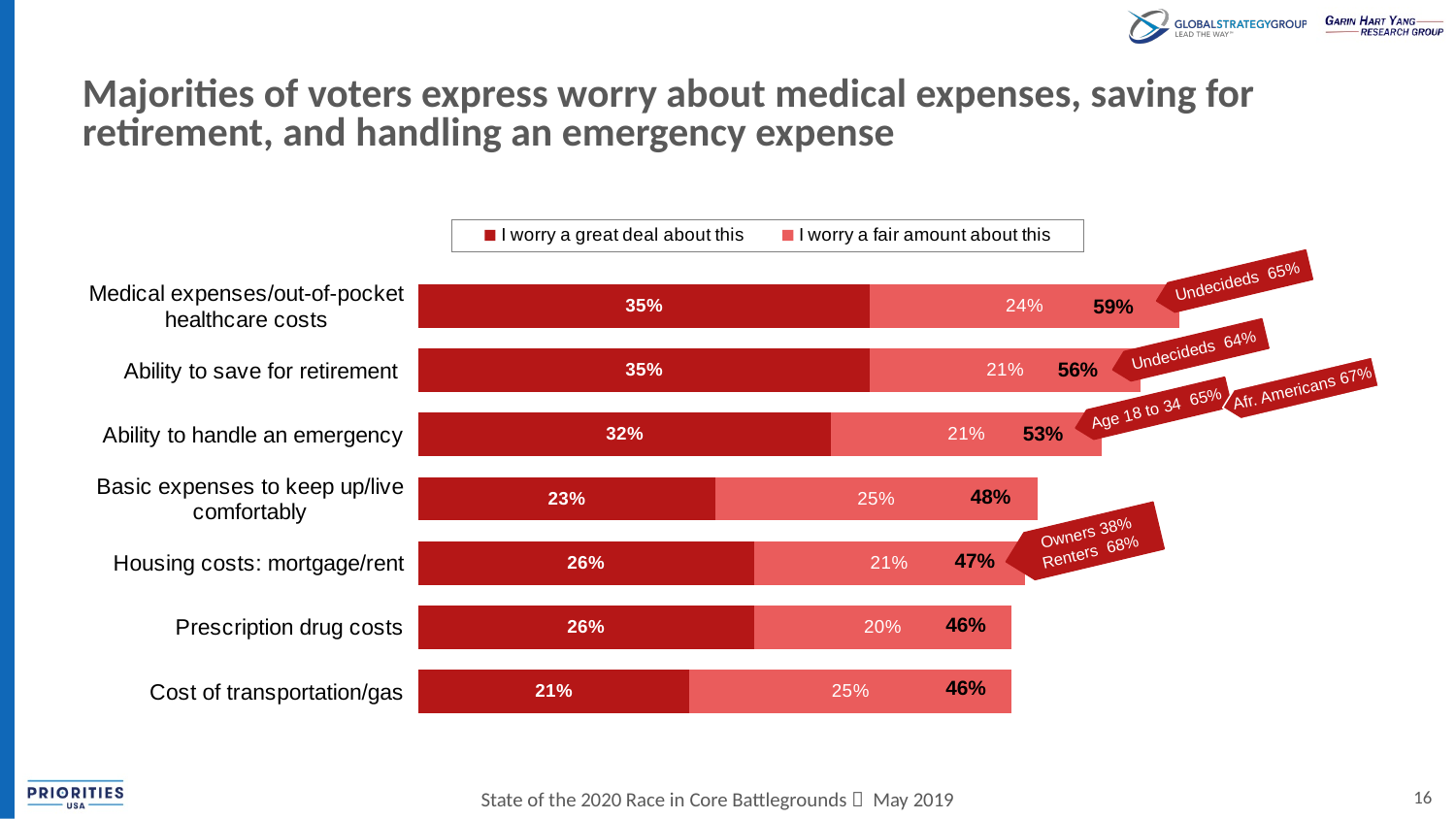
How many series does the legend list? 2 What percentage of voters say they worry a fair amount about the cost of transportation/gas? 25% Which category has the highest combined total of voters who worry a great deal or a fair amount? Medical expenses/out-of-pocket healthcare costs What is the combined total shown for 'Housing costs: mortgage/rent'? 47% What kind of chart is shown on the slide? Stacked bar chart What percentage of voters say they worry a great deal about medical expenses/out-of-pocket healthcare costs? 35% What is the combined total shown for 'Ability to handle an emergency'? 53% What is the difference between the 'I worry a great deal about this' values for 'Ability to save for retirement' and 'Housing costs: mortgage/rent'? 9 percentage points Which category has the lowest 'I worry a great deal about this' value? Cost of transportation/gas How many categories are plotted in the chart? 7 Which is larger: the 'I worry a fair amount about this' value for 'Basic expenses to keep up/live comfortably' or for 'Prescription drug costs'? Basic expenses to keep up/live comfortably What is the title of the chart's slide? Majorities of voters express worry about medical expenses, saving for retirement, and handling an emergency expense